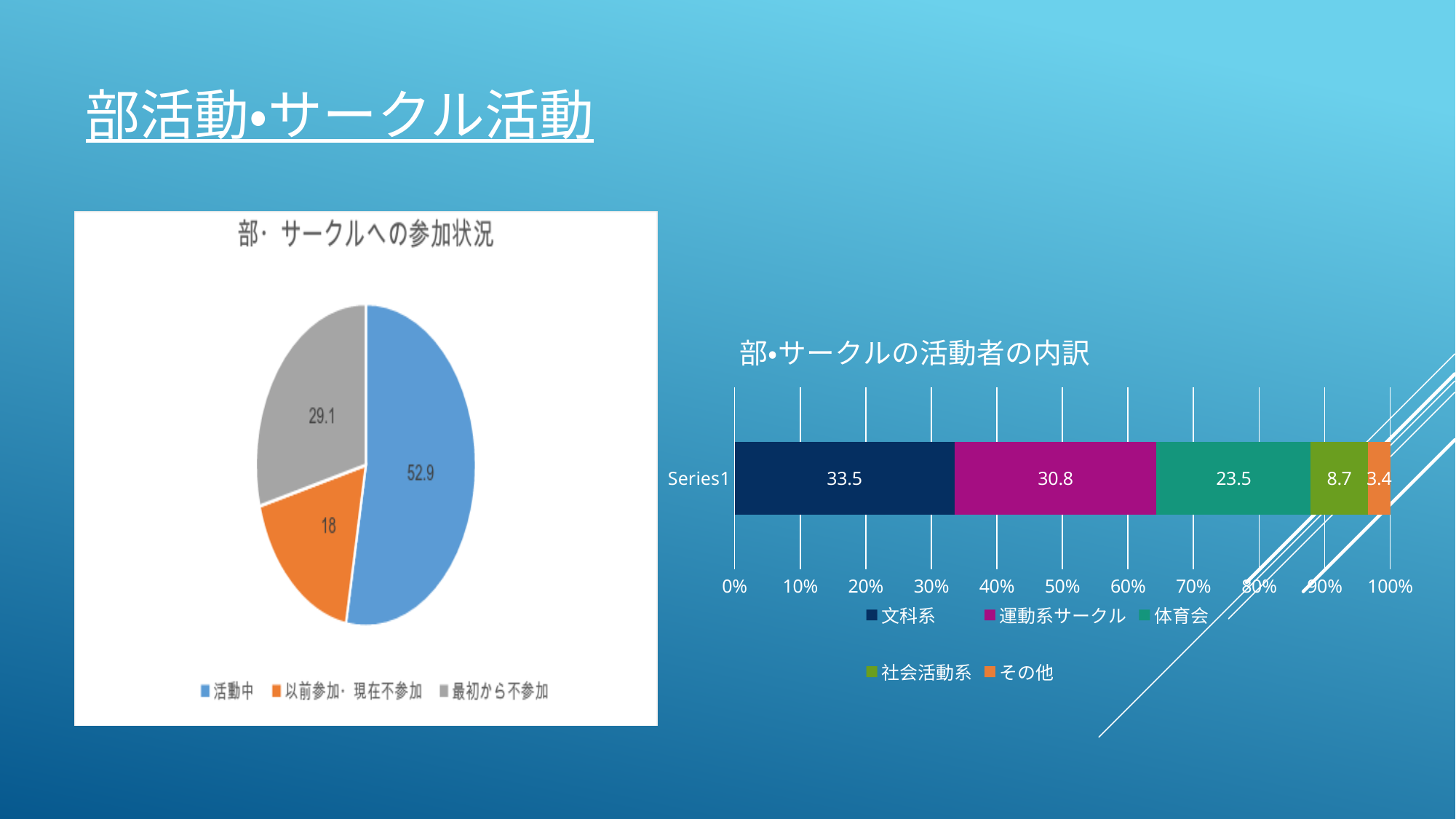
In the chart titled 部•サークルの活動者の内訳, what is the value for 社会活動系? 8.7 In the chart titled 部•サークルの活動者の内訳, which series has the largest value? 文科系 In the chart titled 部•サークルの活動者の内訳, what is the value for 運動系サークル? 30.8 In the chart titled 部•サークルの活動者の内訳, which is larger, 体育会 or その他? 体育会 In the pie chart titled 部・サークルへの参加状況, how many categories does the legend list? 3 In the pie chart titled 部・サークルへの参加状況, what is the difference between the values for 活動中 and 最初から不参加? 23.8 In the chart titled 部•サークルの活動者の内訳, how many series does the legend list? 5 In the pie chart titled 部・サークルへの参加状況, which category has the largest slice? 活動中 In the pie chart titled 部・サークルへの参加状況, what is the value for 活動中? 52.9 In the pie chart titled 部・サークルへの参加状況, what is the value for 最初から不参加? 29.1 In the pie chart titled 部・サークルへの参加状況, which category has the smallest slice? 以前参加・現在不参加 What kind of chart is the one titled 部•サークルの活動者の内訳? Stacked bar chart